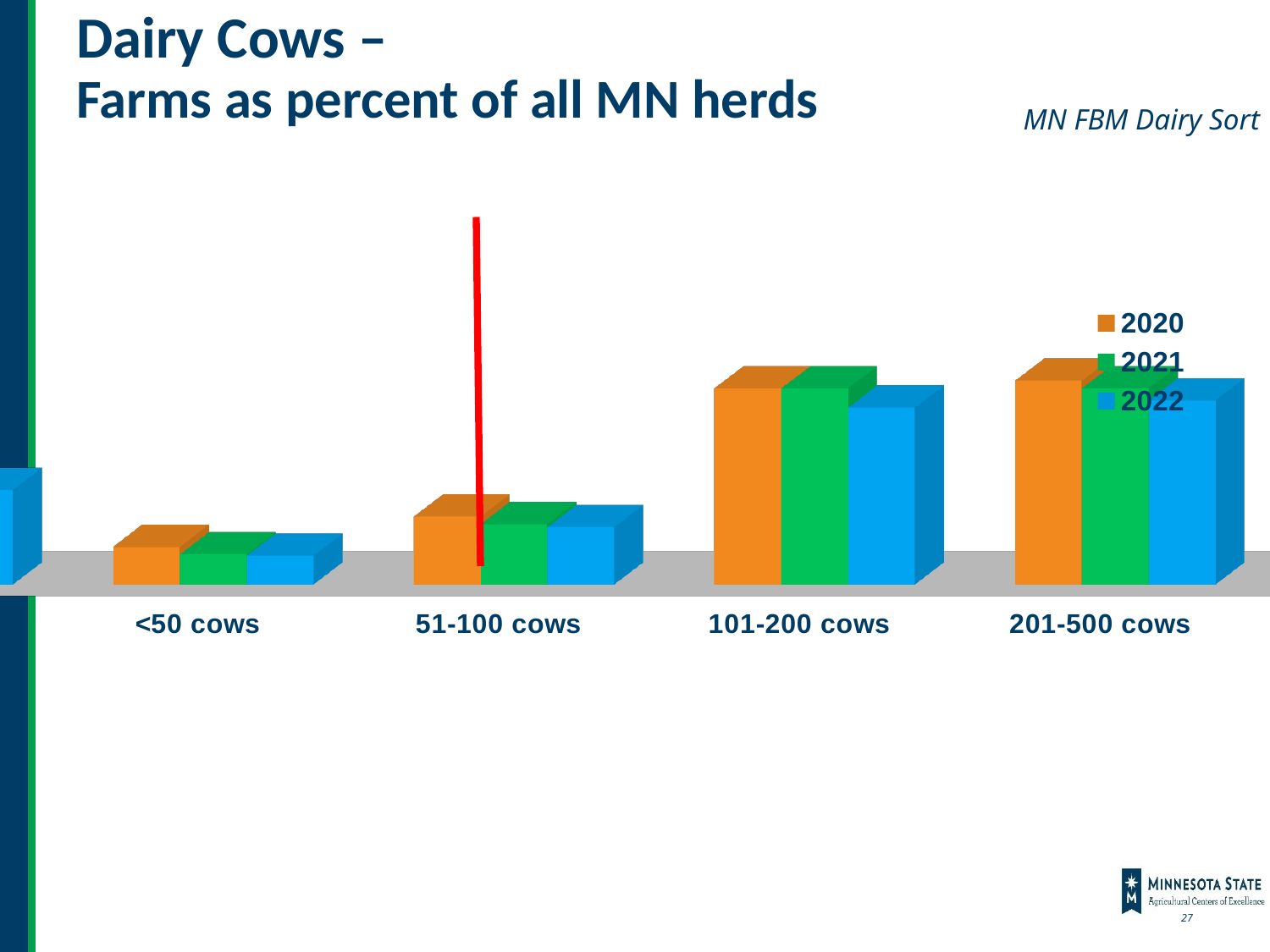
What colour represents the 2022 series in the chart? Blue How many series does the legend list? 3 Which is larger for 2020: the value for <50 cows or the value for 51-100 cows? 51-100 cows What years are listed in the chart legend? 2020, 2021, 2022 Within the 101-200 cows category, is the 2022 bar higher or lower than the 2020 bar? Lower Do the values rise or fall moving from <50 cows to 101-200 cows along the x axis? Rise What kind of chart is shown on the slide? Bar chart Which is larger for 2022: the value for 101-200 cows or the value for <50 cows? 101-200 cows How many herd-size categories are shown on the x axis? 4 Which herd-size category has the lowest values across all three years? <50 cows